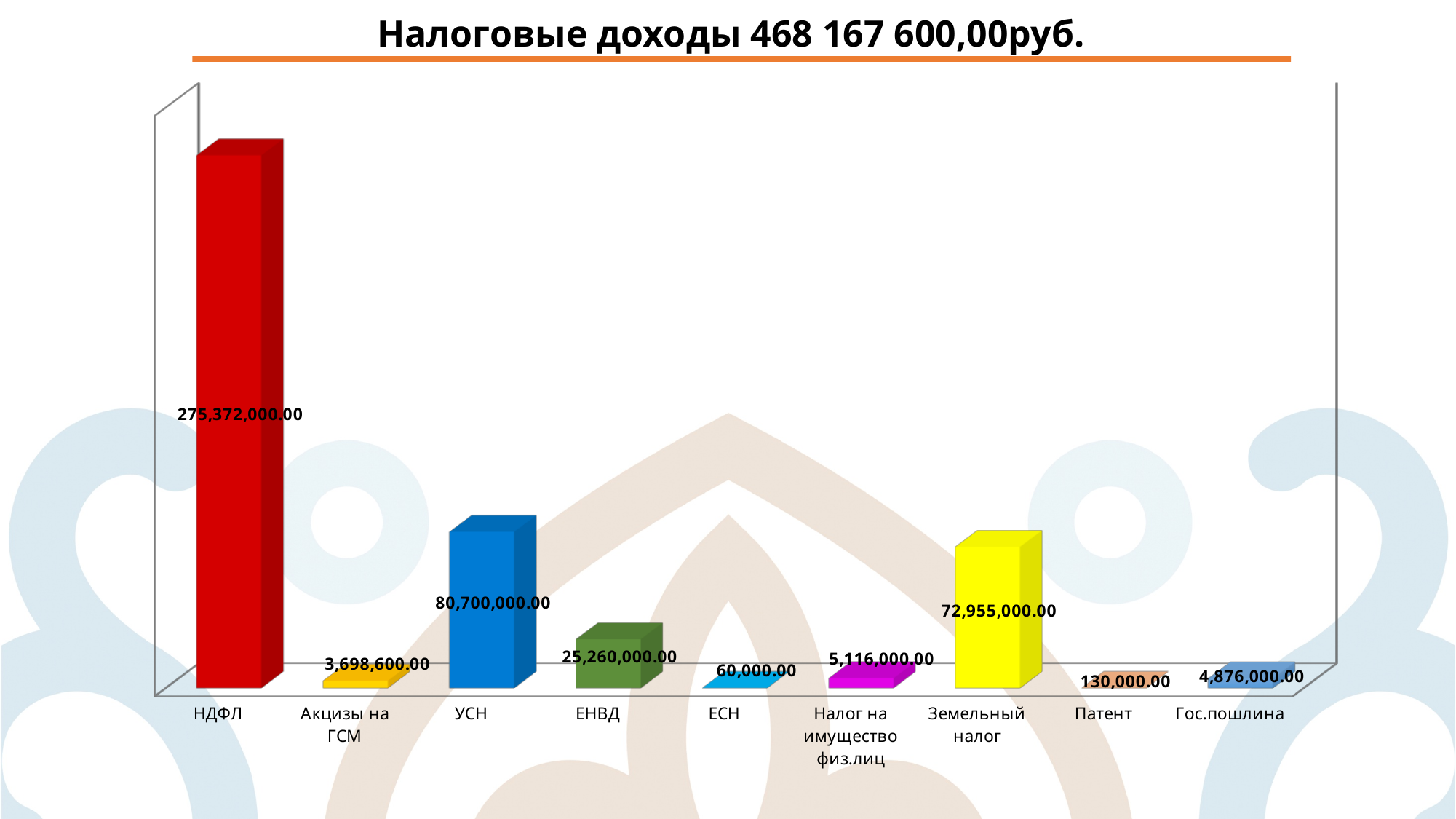
What is the value for Налог на имущество физ.лиц? 5,116,000.00 What is the value for НДФЛ? 275,372,000.00 How many categories are shown in the chart? 9 What is the value for Земельный налог? 72,955,000.00 Which is larger, the value for ЕНВД or the value for Земельный налог? Земельный налог What is the difference between the values for УСН and Земельный налог? 7,745,000.00 What is the title of the chart? Налоговые доходы 468 167 600,00руб. What kind of chart is shown on the slide? Bar chart What is the value for Акцизы на ГСМ? 3,698,600.00 Which category has the highest value? НДФЛ Which category has the lowest value? ЕСН What is the difference between the values for Гос.пошлина and Акцизы на ГСМ? 1,177,400.00